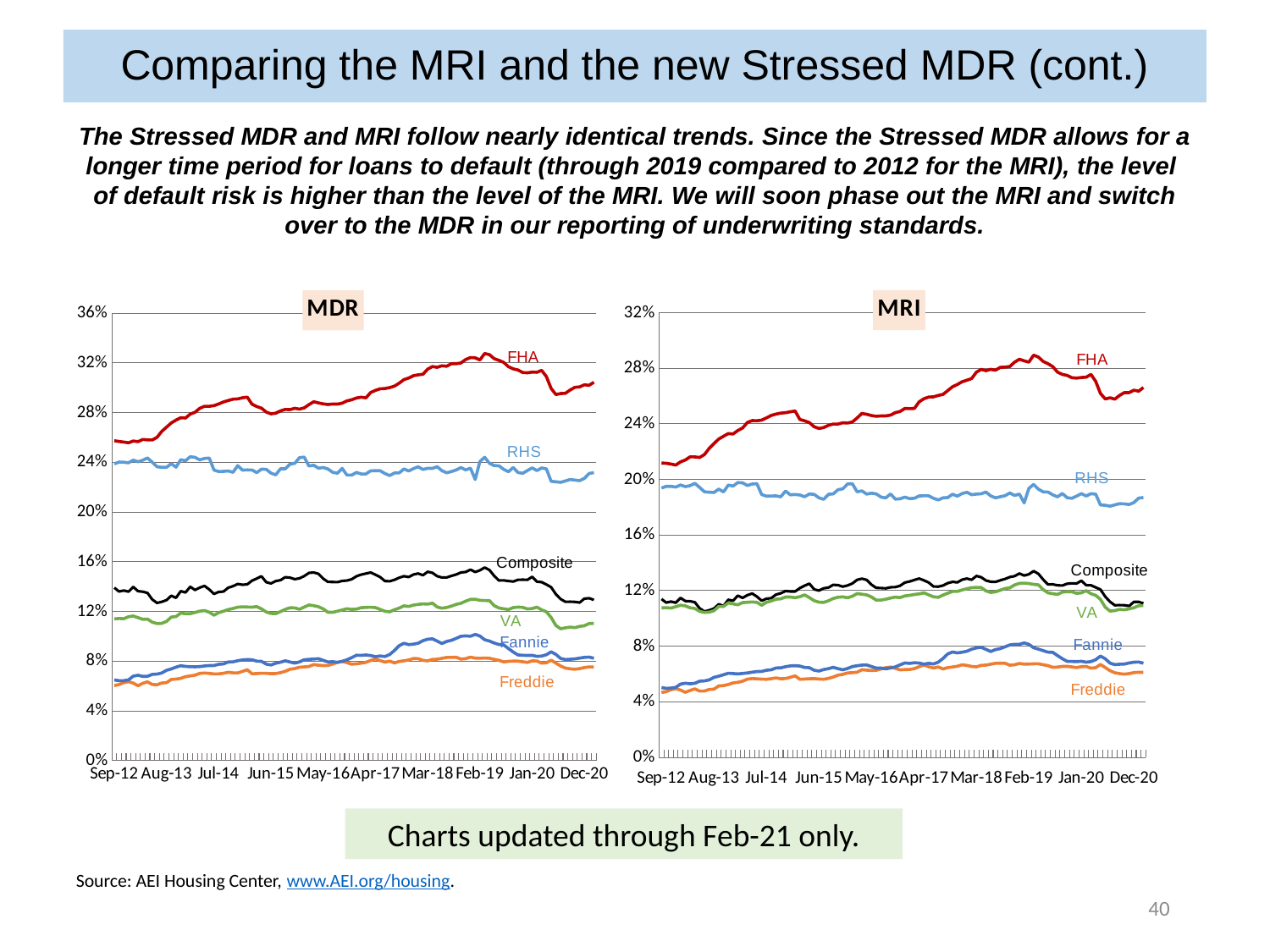
What kind of chart is the MDR chart on the left? line chart On the MDR chart, does the FHA line rise or fall overall from Sep-12 to Dec-20? rise How many series are plotted on the MRI chart? 6 On the MDR chart, which series has the highest values? FHA On the MRI chart, is the FHA value at Sep-12 greater or less than 24%? less What is the first date label on the x axis of the MRI chart? Sep-12 What is the highest value shown on the y axis of the MDR chart? 36% On the MDR chart, is the Freddie value at Sep-12 greater or less than 8%? less On the MRI chart, which series is higher, Composite or VA? Composite On the MRI chart, is the RHS value at Dec-20 greater or less than 20%? less On the MRI chart, which series has the lowest values? Freddie